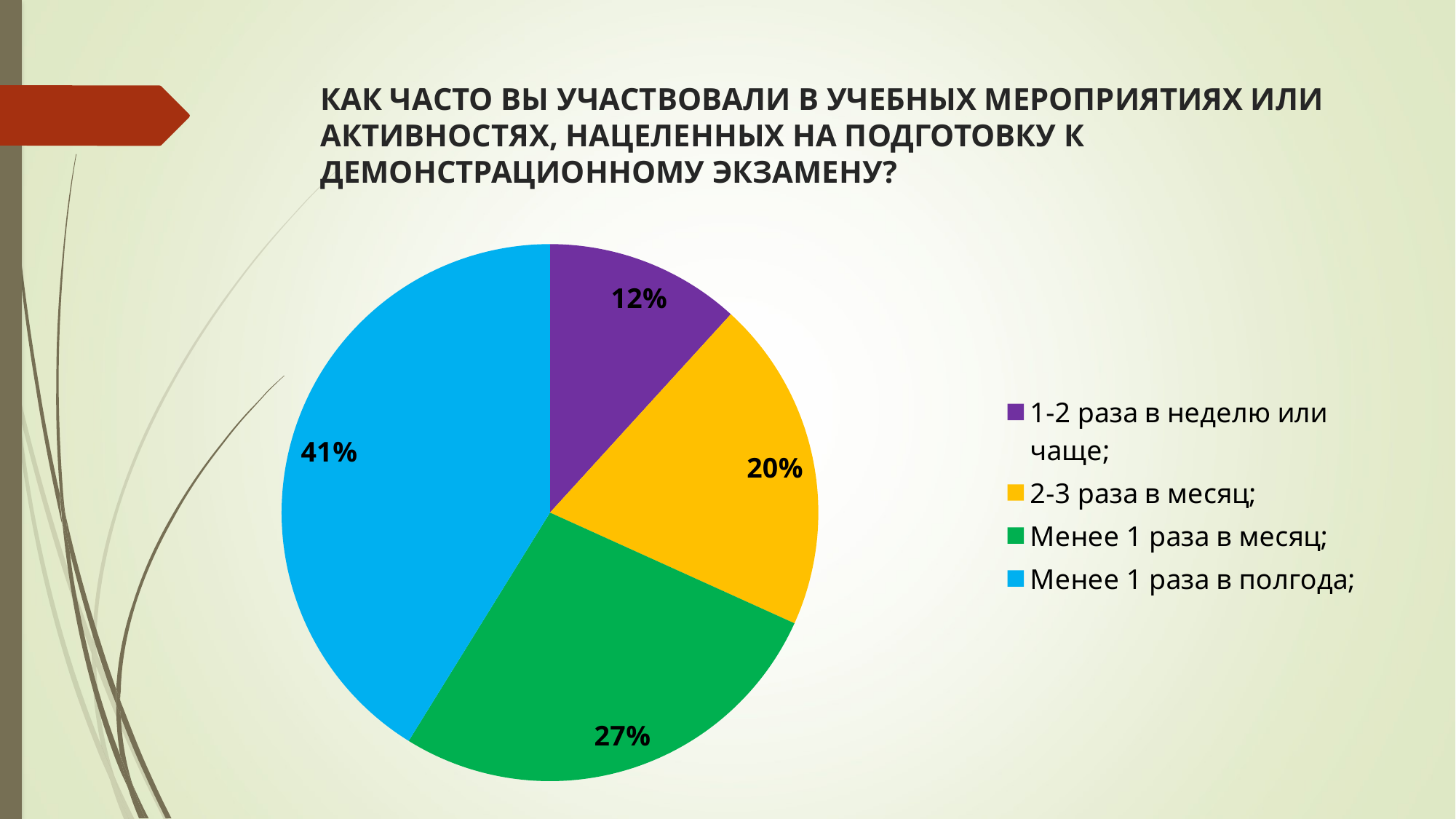
What kind of chart is shown on the slide? Pie chart What is the difference between the values for "Менее 1 раза в полгода;" and "Менее 1 раза в месяц;"? 14% What is the value for "2-3 раза в месяц;"? 20% What is the value for "Менее 1 раза в месяц;"? 27% What is the value for "1-2 раза в неделю или чаще;"? 12% What colour is the slice for "2-3 раза в месяц;"? Yellow Which category has the largest slice? Менее 1 раза в полгода; Which category has the smallest slice? 1-2 раза в неделю или чаще; Which is larger: the value for "2-3 раза в месяц;" or the value for "Менее 1 раза в месяц;"? Менее 1 раза в месяц; What is the difference between the values for "2-3 раза в месяц;" and "1-2 раза в неделю или чаще;"? 8% How many categories does the pie chart have? 4 What share of the pie does "Менее 1 раза в полгода;" take? 41%